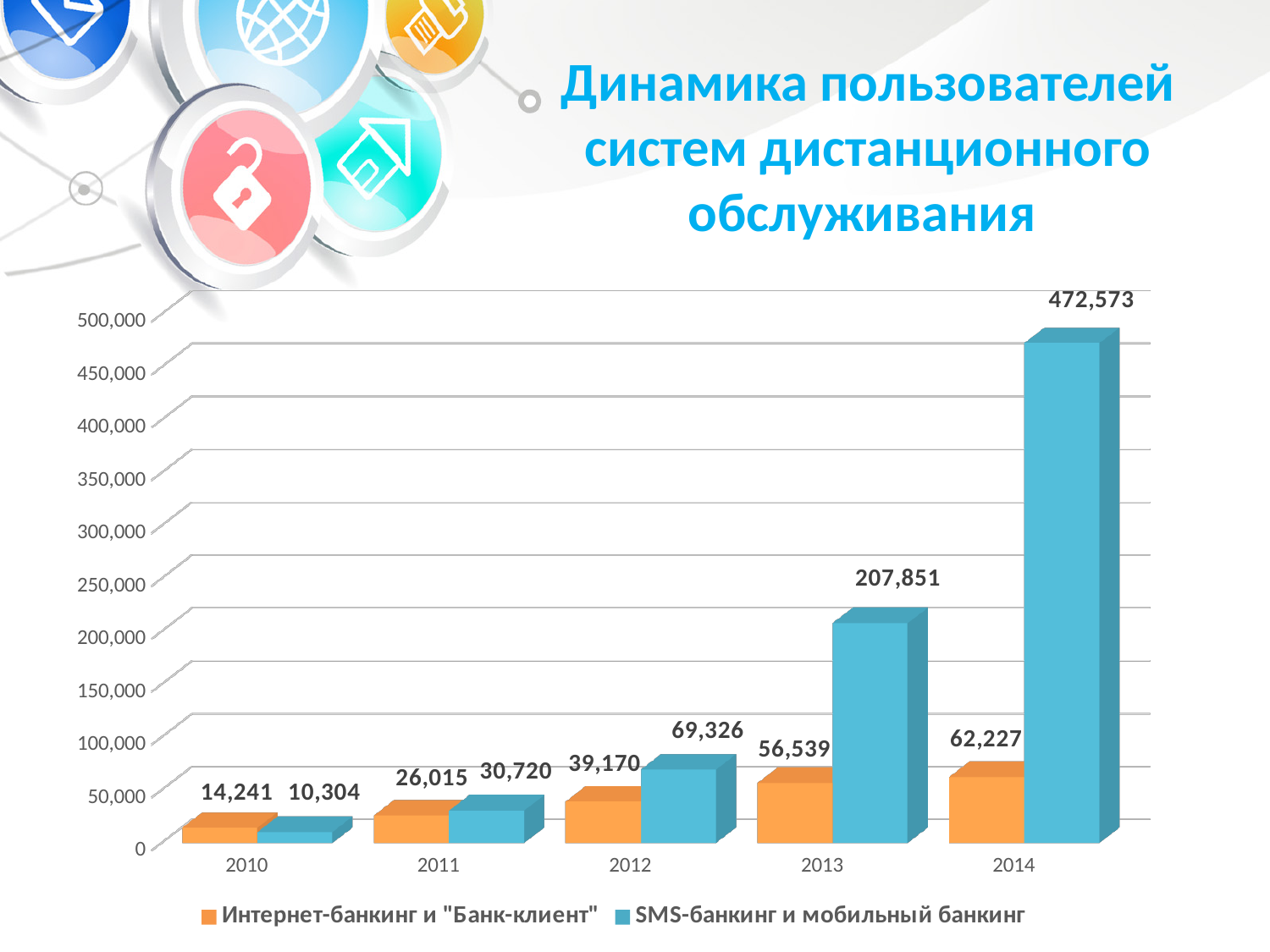
How many series does the legend list? 2 In 2010, which series has the larger value: Интернет-банкинг и "Банк-клиент" or SMS-банкинг и мобильный банкинг? Интернет-банкинг и "Банк-клиент" Is the value for SMS-банкинг и мобильный банкинг in 2013 greater or less than 250,000? less In which year is the value for Интернет-банкинг и "Банк-клиент" the lowest? 2010 What kind of chart is shown on the slide? Bar chart What is the value for SMS-банкинг и мобильный банкинг in 2012? 69,326 How many years are shown on the x axis? 5 What is the value for SMS-банкинг и мобильный банкинг in 2014? 472,573 What is the value for Интернет-банкинг и "Банк-клиент" in 2013? 56,539 What is the difference between the SMS-банкинг и мобильный банкинг values for 2014 and 2013? 264,722 What is the value for Интернет-банкинг и "Банк-клиент" in 2010? 14,241 In which year is the value for SMS-банкинг и мобильный банкинг the highest? 2014